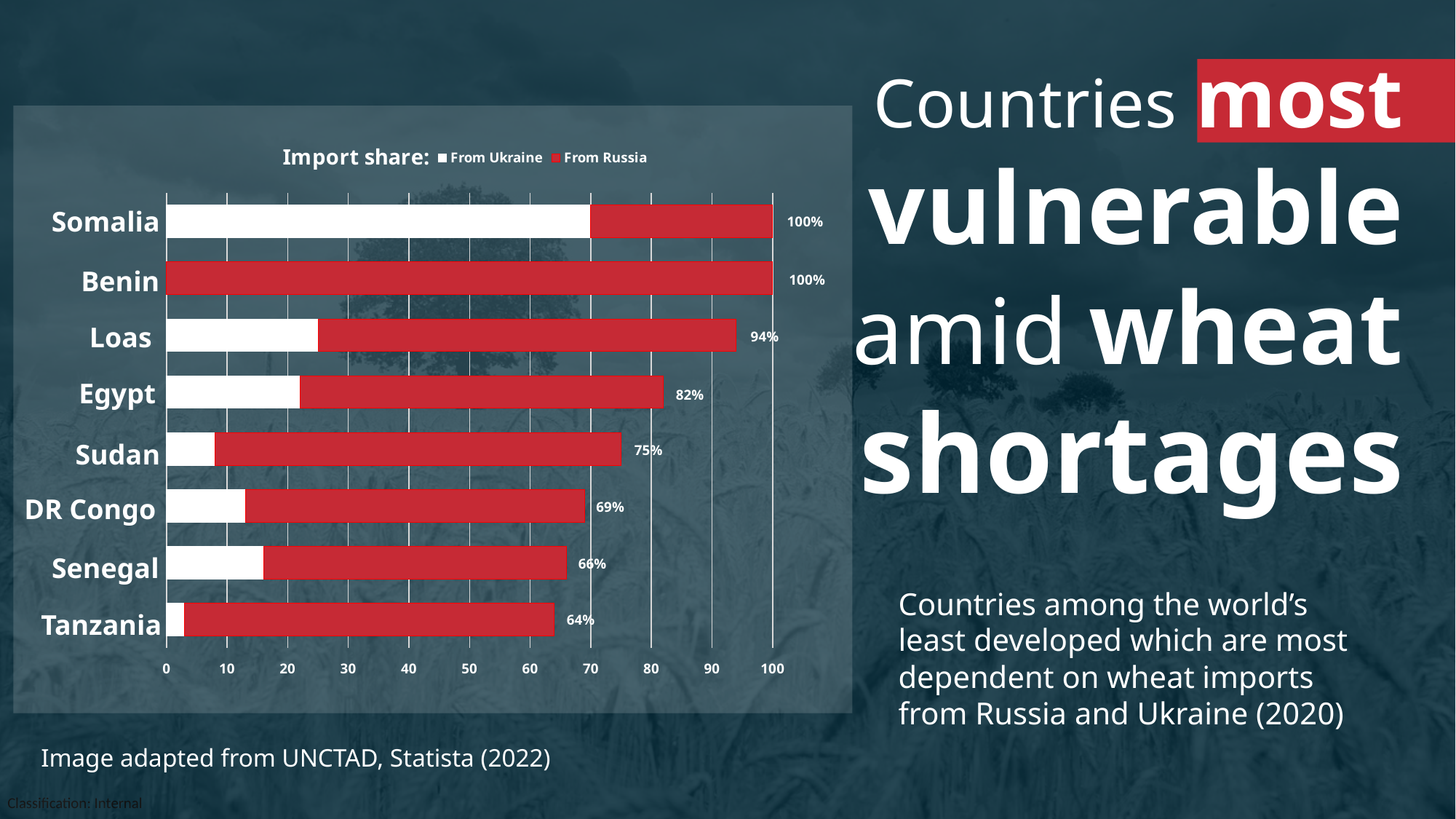
What is the total import share shown for Egypt? 82% Is the 'From Ukraine' value for Somalia greater or less than 60? greater How many countries are shown in the chart? 8 Which has a larger total import share, DR Congo or Egypt? Egypt What is the total import share shown for Sudan? 75% What is the difference between the total import share of Loas and that of Senegal? 28% What is the total import share shown for Tanzania? 64% What kind of chart is shown on the slide? Stacked bar chart Is the 'From Ukraine' value for Egypt greater or less than 30? less Which colour represents the 'From Russia' series in the chart? Red How many series does the chart legend list? 2 Which country has the lowest total import share in the chart? Tanzania